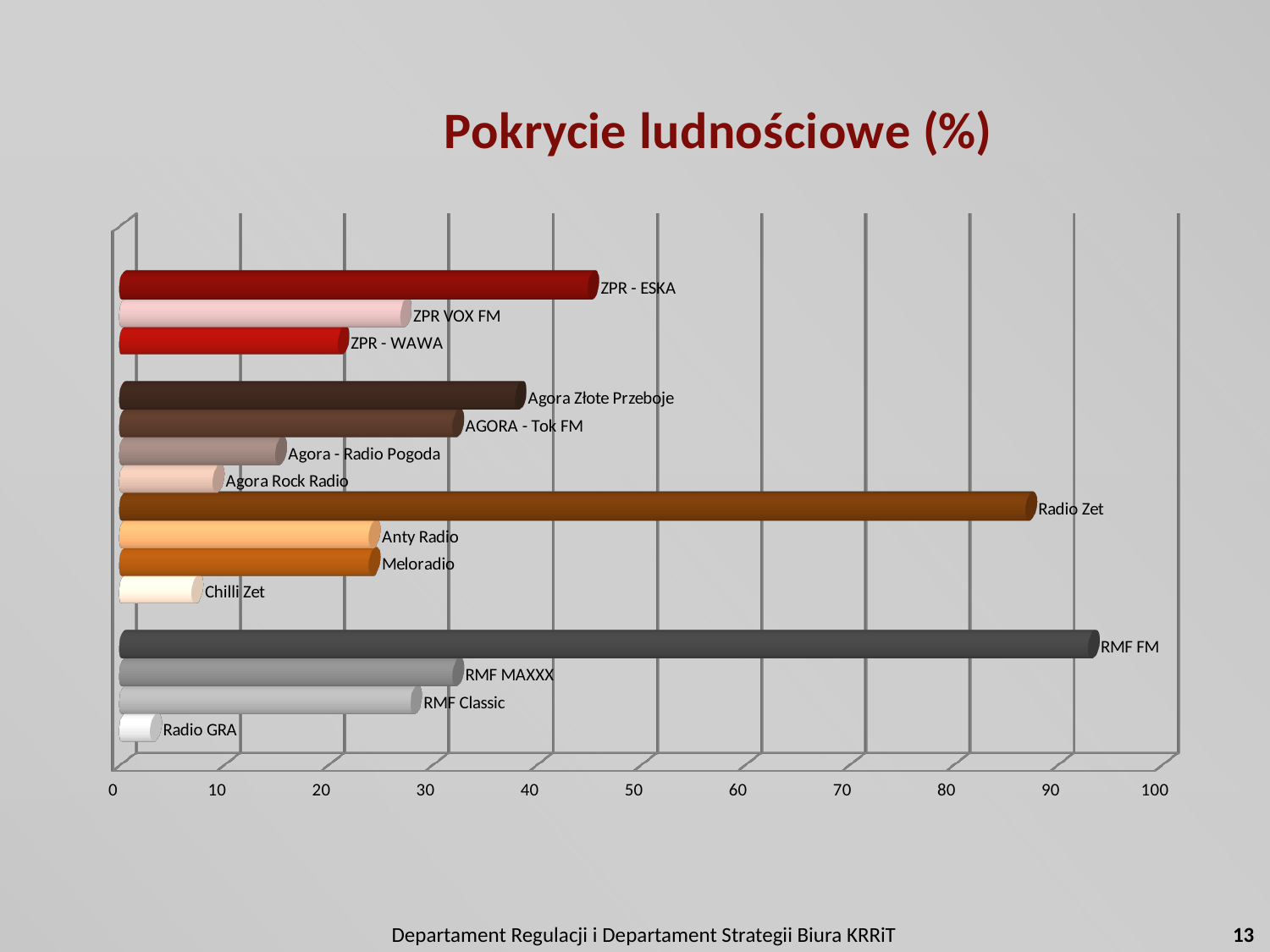
Is the value for ZPR - ESKA greater or less than 40? greater Is the value for ZPR - WAWA greater or less than 30? less Which radio station has the highest population coverage? RMF FM What is the title of the chart? Pokrycie ludnościowe (%) Which has a larger value, Agora Rock Radio or Agora - Radio Pogoda? Agora - Radio Pogoda How many radio stations are plotted in the chart? 15 Is the value for RMF FM greater or less than 90? greater What kind of chart is shown on the slide? bar chart Which radio station has the lowest population coverage? Radio GRA Which has a larger value, Radio Zet or RMF FM? RMF FM